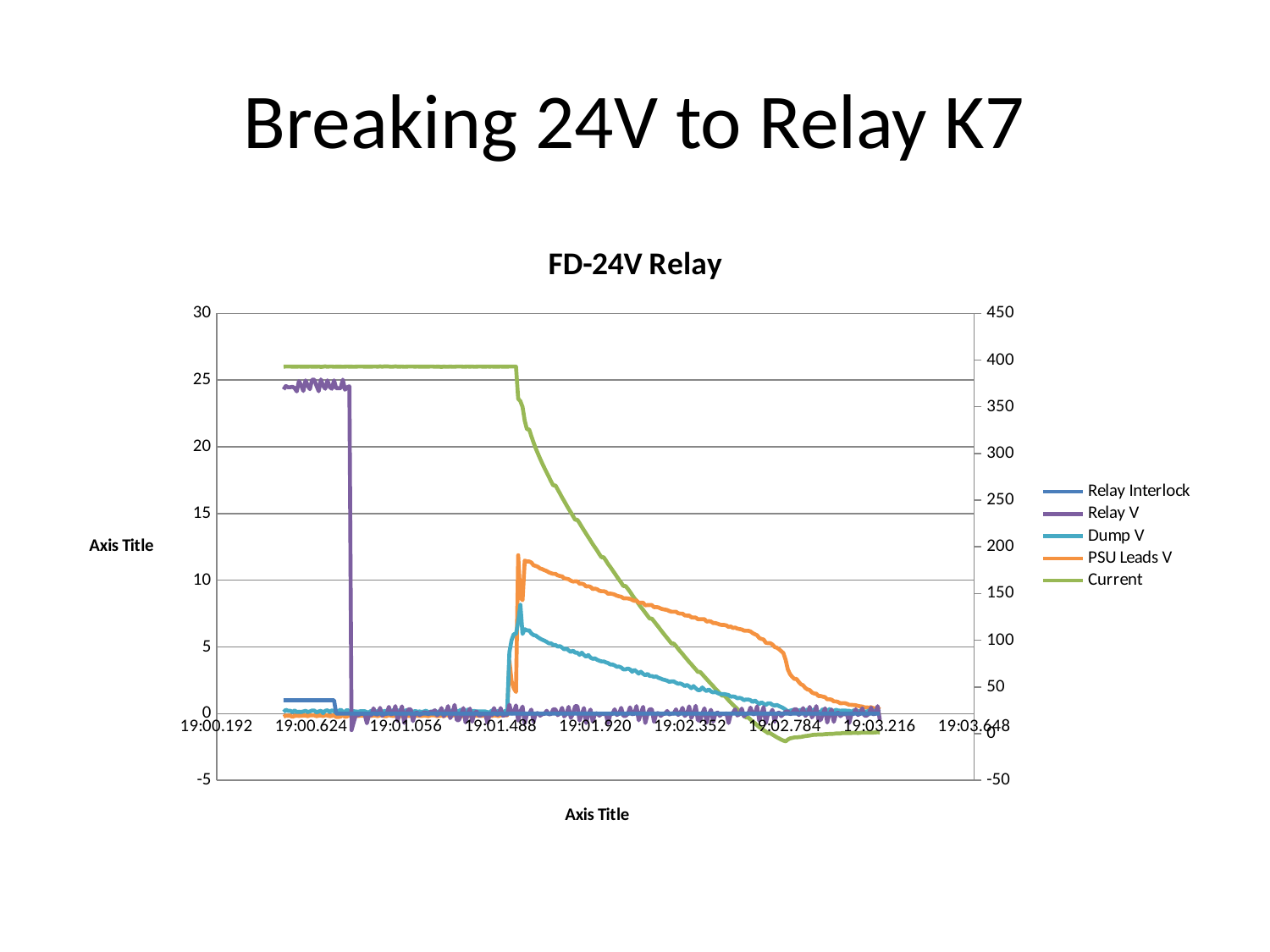
How many series does the legend list? 5 Does the Relay V line rise or fall at around 19:00.8? fall Does the Current line rise or fall between 19:01.488 and 19:02.784? fall What is the highest value shown on the right-hand vertical axis? 450 What kind of chart is shown on the slide? line chart Does the PSU Leads V line rise or fall between 19:01.920 and 19:03.216? fall What is the title of the chart? FD-24V Relay Which series is drawn in green according to the legend? Current Before 19:00.8, which line is higher: Relay V or Relay Interlock? Relay V Is the initial value of Relay V (before it drops) greater or less than 20 on the left axis? greater Is the peak of the Dump V line greater or less than 10 on the left axis? less At 19:01.920, which line is higher: PSU Leads V or Dump V? PSU Leads V